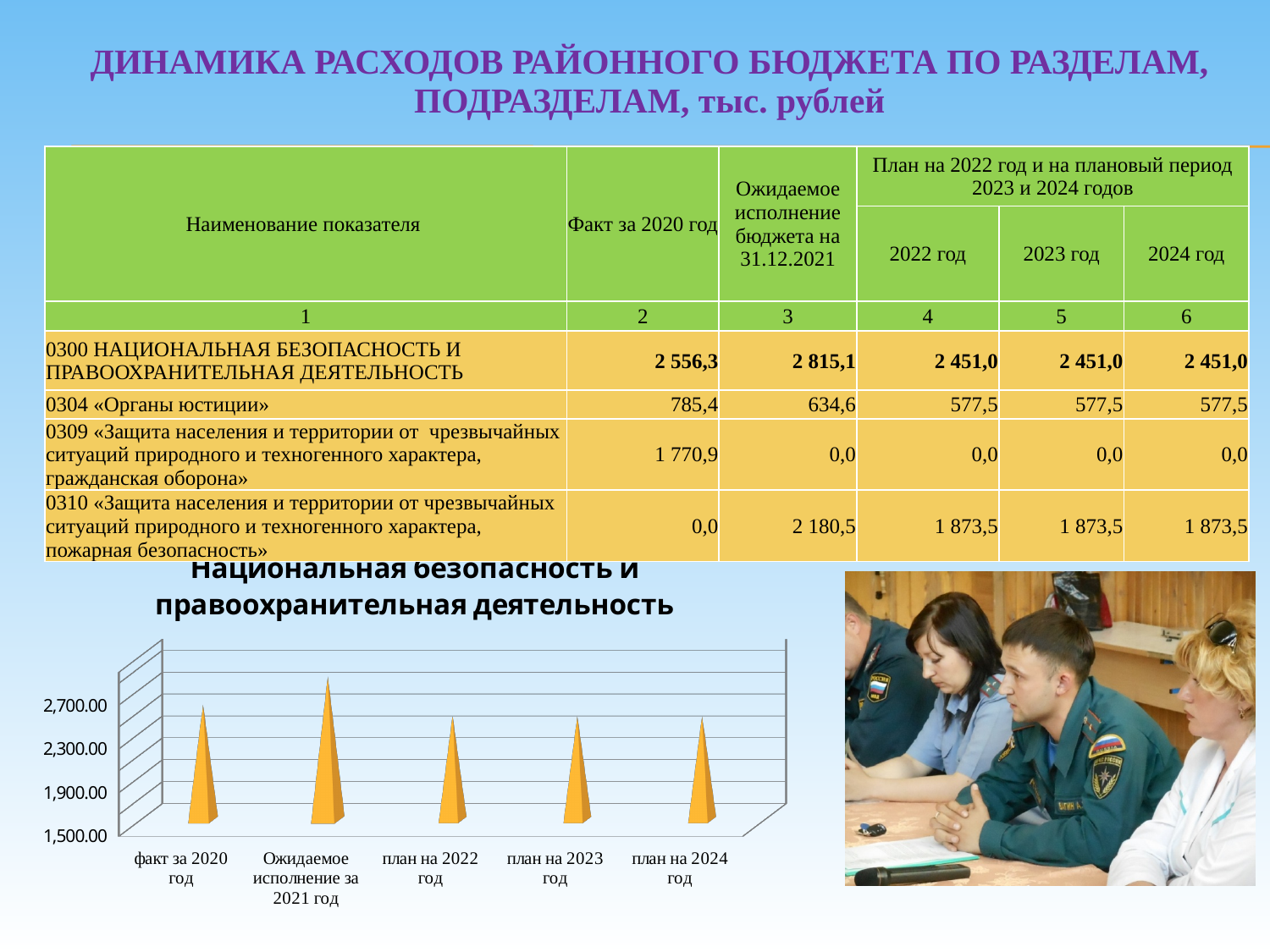
Which is larger in the chart: 'факт за 2020 год' or 'план на 2023 год'? факт за 2020 год Do the bars rise or fall from 'Ожидаемое исполнение за 2021 год' to 'план на 2022 год'? fall What is the lowest value shown on the chart's vertical axis? 1,500.00 Which category has the highest bar in the chart? Ожидаемое исполнение за 2021 год Is the value for 'план на 2022 год' greater or less than 1,900.00? greater Is the value for 'факт за 2020 год' greater or less than 2,300.00? greater What is the title of the chart on the slide? Национальная безопасность и правоохранительная деятельность What type of chart is shown on the slide? bar chart Is the value for 'Ожидаемое исполнение за 2021 год' greater or less than 2,700.00? greater According to the table row matching the chart, what is the value for 'Ожидаемое исполнение за 2021 год'? 2 815,1 How many categories are shown on the x axis of the chart? 5